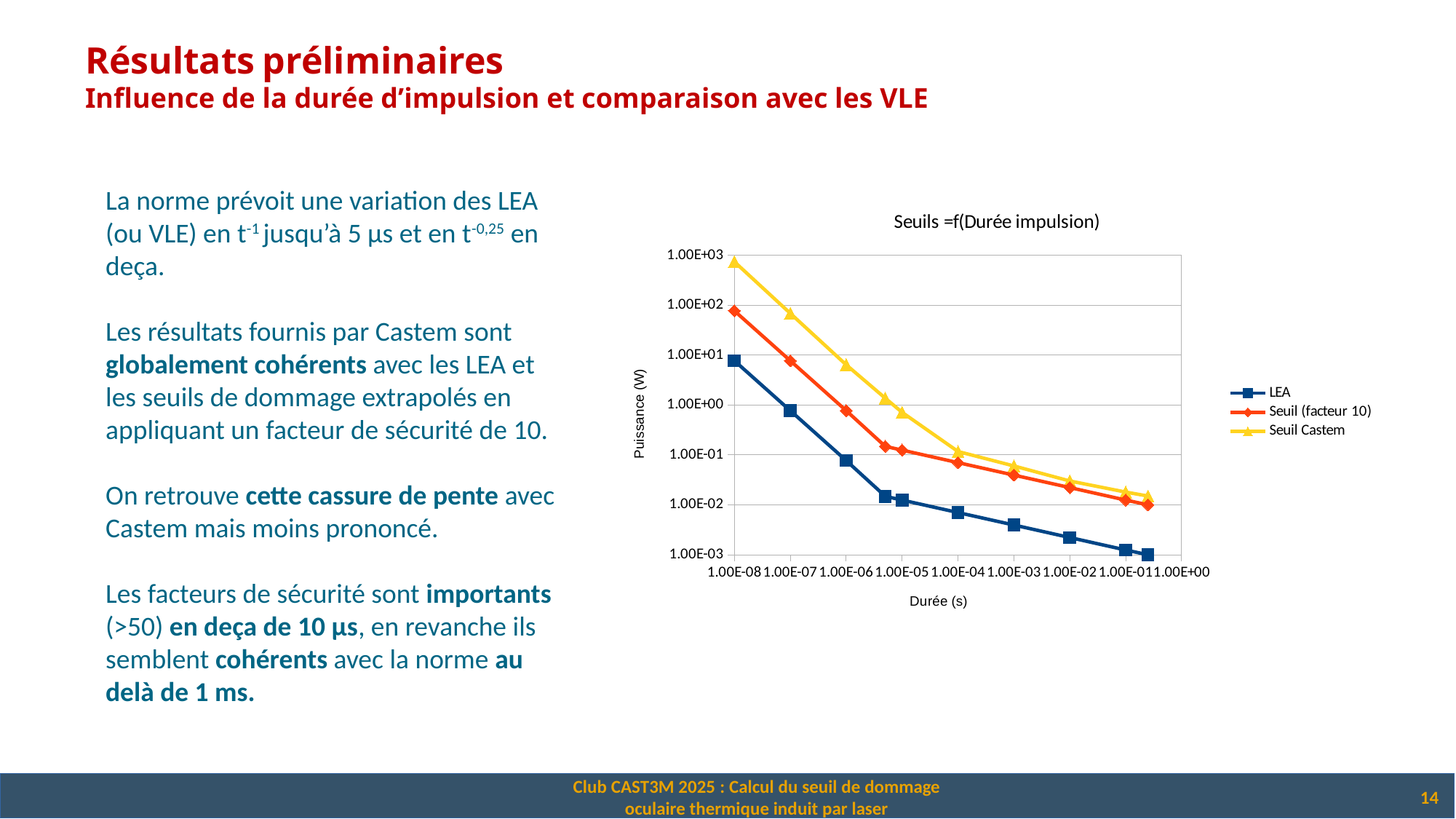
What is the label of the vertical axis of the chart? Puissance (W) How many series does the legend of the chart list? 3 At a duration of 1.00E-03 s, which is larger: the Seuil (facteur 10) value or the LEA value? Seuil (facteur 10) Which series has the highest values across the chart? Seuil Castem What is the title of the chart? Seuils =f(Durée impulsion) Which series has the lowest values across the chart? LEA Is the Seuil Castem value at a duration of 1.00E-06 s greater or less than 1.00E+00? greater At a duration of 1.00E-08 s, which is larger: the Seuil Castem value or the LEA value? Seuil Castem What kind of chart is shown on the slide? Line chart Is the LEA value at a duration of 1.00E-08 s greater or less than 1.00E+00? greater Do the values of the LEA series rise or fall as the duration increases along the x axis? Fall